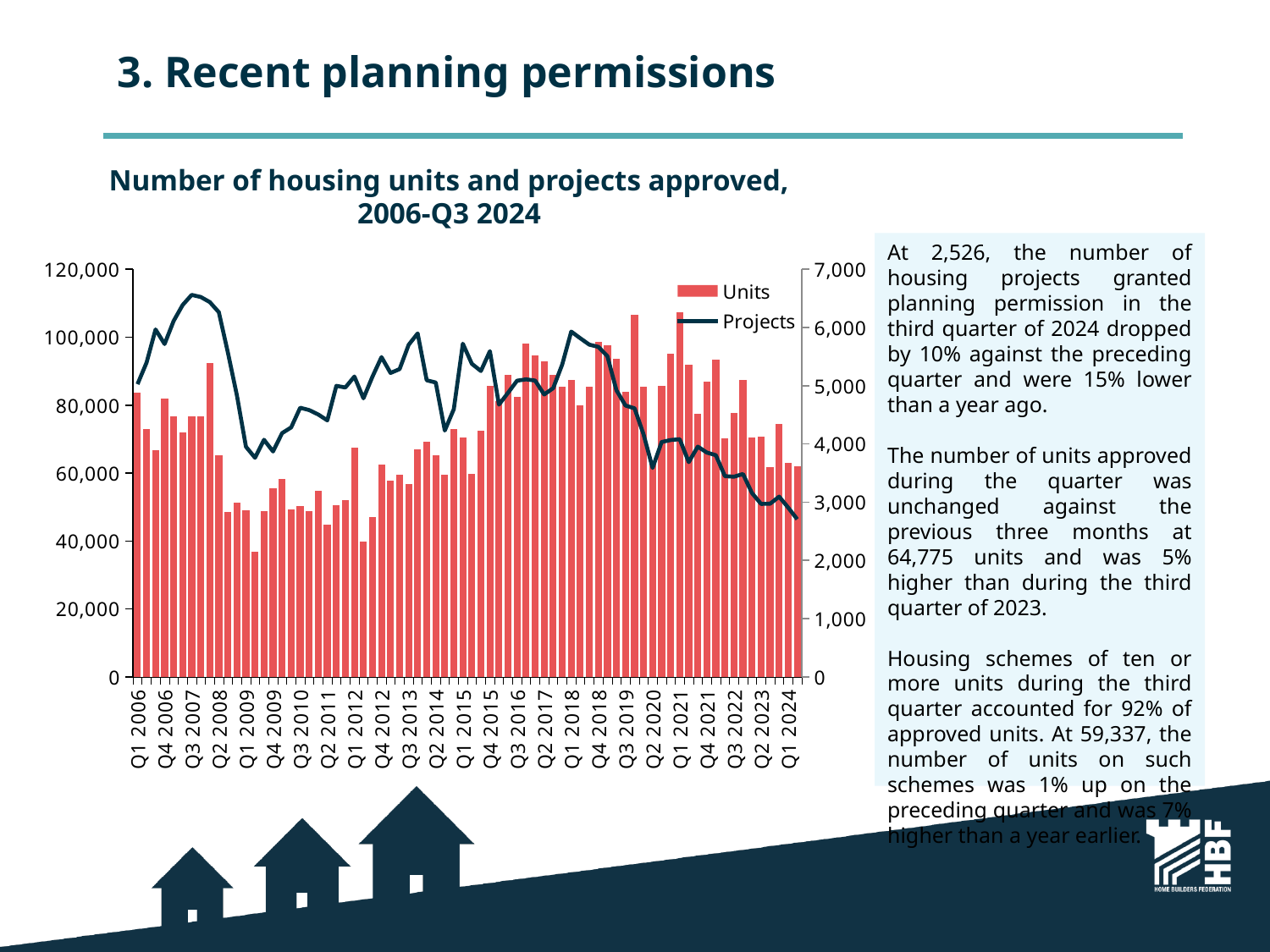
Which is larger, the Projects value in Q3 2007 or in Q1 2024? Q3 2007 Is the value for Units in Q3 2007 greater or less than 80,000? less Is the value for Units in Q1 2009 greater or less than 40,000? greater Which is larger, the Units value in Q1 2006 or in Q1 2009? Q1 2006 Does the Projects line rise or fall between Q1 2018 and Q1 2024? Fall What kind of chart is shown on the slide? A combined bar and line chart What is the title of the chart? Number of housing units and projects approved, 2006-Q3 2024 How many series does the legend list? 2 Is the value for Projects in Q3 2007 greater or less than 6,000? greater What are the two series named in the legend? Units and Projects